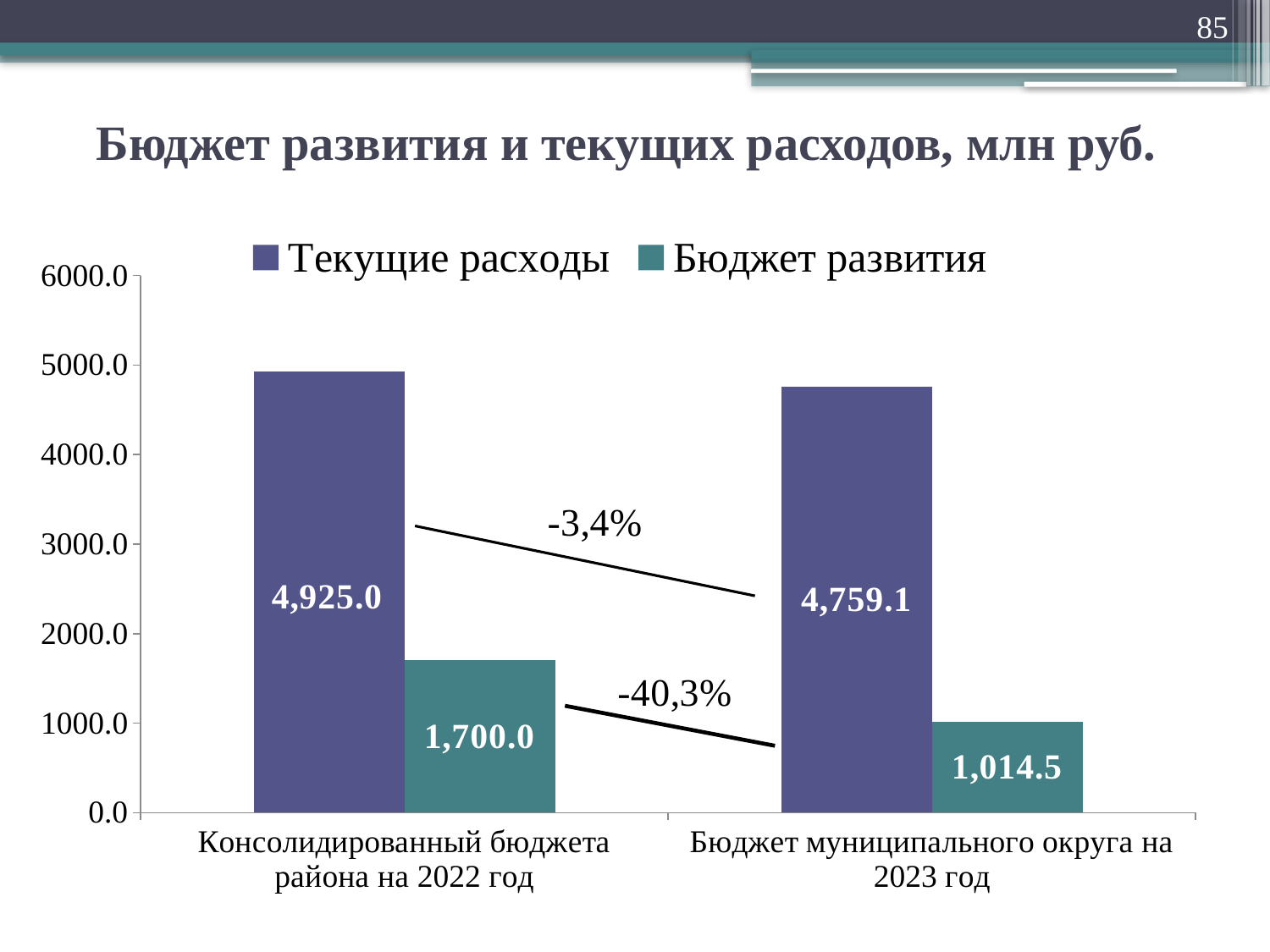
Which bar has the lowest value on the chart? Бюджет развития, Бюджет муниципального округа на 2023 год What is the value of Бюджет развития for Консолидированный бюджета района на 2022 год? 1,700.0 Which is larger: Текущие расходы for 2022 or Текущие расходы for 2023? Текущие расходы for 2022 What is the value of Бюджет развития for Бюджет муниципального округа на 2023 год? 1,014.5 What percentage change is annotated between the Бюджет развития bars? -40,3% How many categories are shown on the x axis? 2 What kind of chart is shown on the slide? Bar chart Which bar has the highest value on the chart? Текущие расходы, Консолидированный бюджета района на 2022 год What is the difference between Бюджет развития in 2022 (1,700.0) and in 2023 (1,014.5)? 685.5 What is the value of Текущие расходы for Консолидированный бюджета района на 2022 год? 4,925.0 How many series does the legend list? 2 What is the value of Текущие расходы for Бюджет муниципального округа на 2023 год? 4,759.1